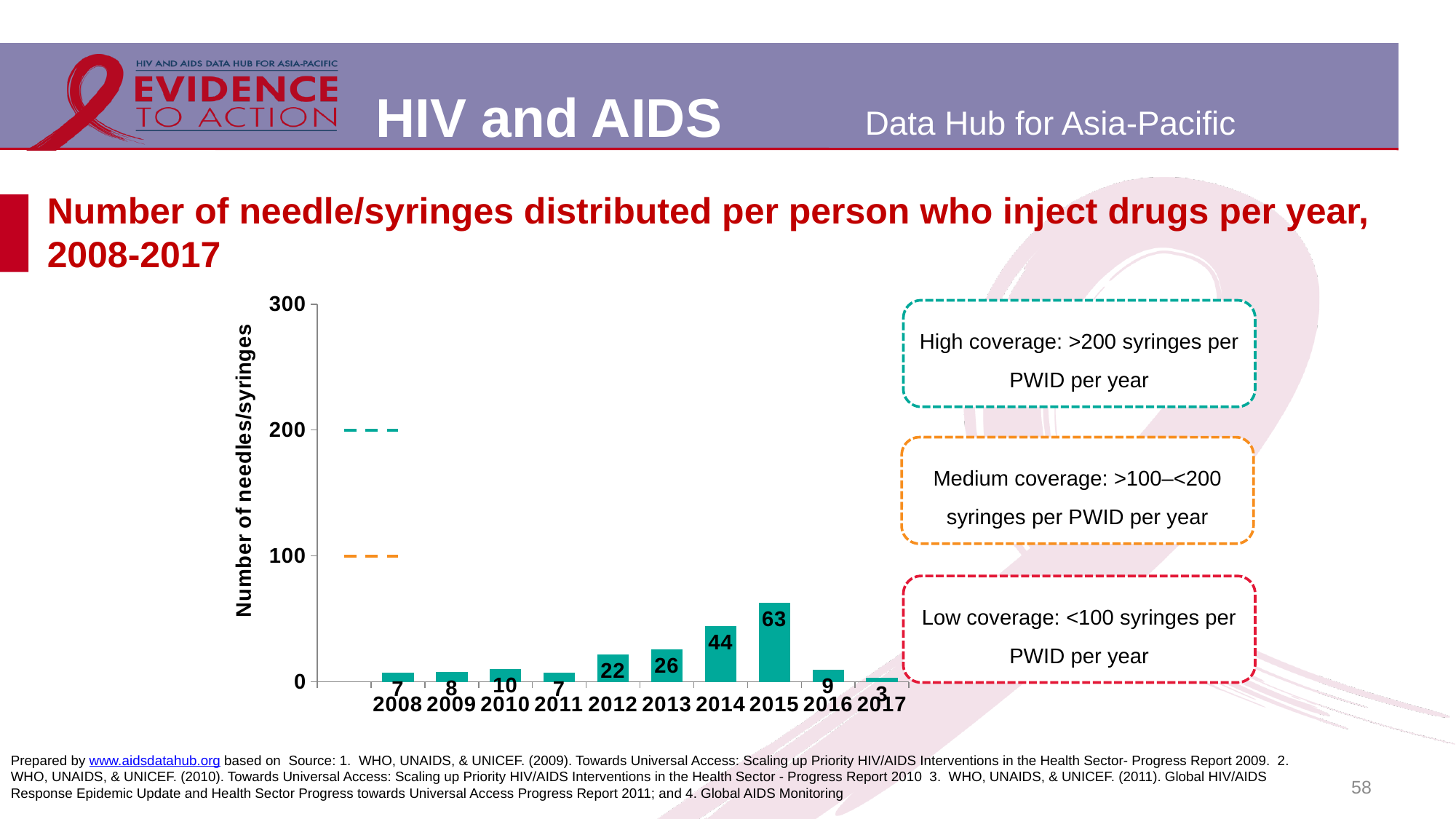
Is the value for 2015 greater or less than 100? less Which year has the highest number of needles/syringes distributed per person? 2015 What kind of chart is shown on the slide? bar chart Which year has the lowest number of needles/syringes distributed per person? 2017 Which year has a larger value, 2013 or 2016? 2013 Do the values rise or fall from 2015 to 2017? fall What is the value shown for 2017? 3 What is the difference between the values for 2015 and 2014? 19 What is the value shown for 2012? 22 What is the label of the y axis of the chart? Number of needles/syringes What is the number of needles/syringes distributed per person who injects drugs in 2015? 63 How many years are shown on the x axis of the chart? 10